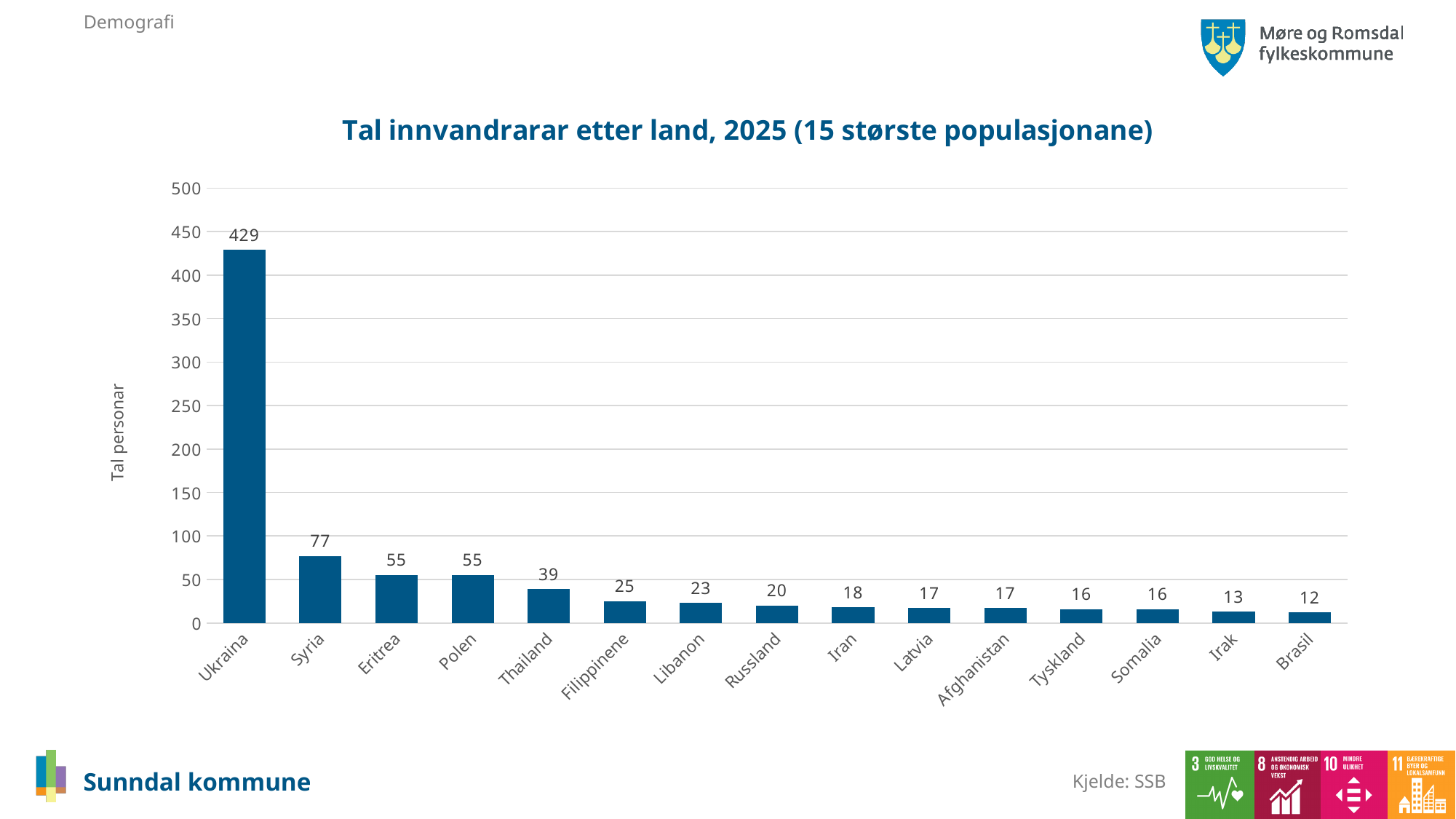
What is the value for Thailand? 39 How many countries are shown on the x axis? 15 What is the difference between the values for Thailand and Filippinene? 14 Which country has the lowest value? Brasil What is the difference between the values for Ukraina and Syria? 352 What is the title of the chart? Tal innvandrarar etter land, 2025 (15 største populasjonane) Which country has the highest value? Ukraina What is the value for Ukraina? 429 Is the value for Syria greater or less than 100? less What is the value for Libanon? 23 Which is larger, the value for Syria or the value for Eritrea? Syria What kind of chart is shown on the slide? bar chart